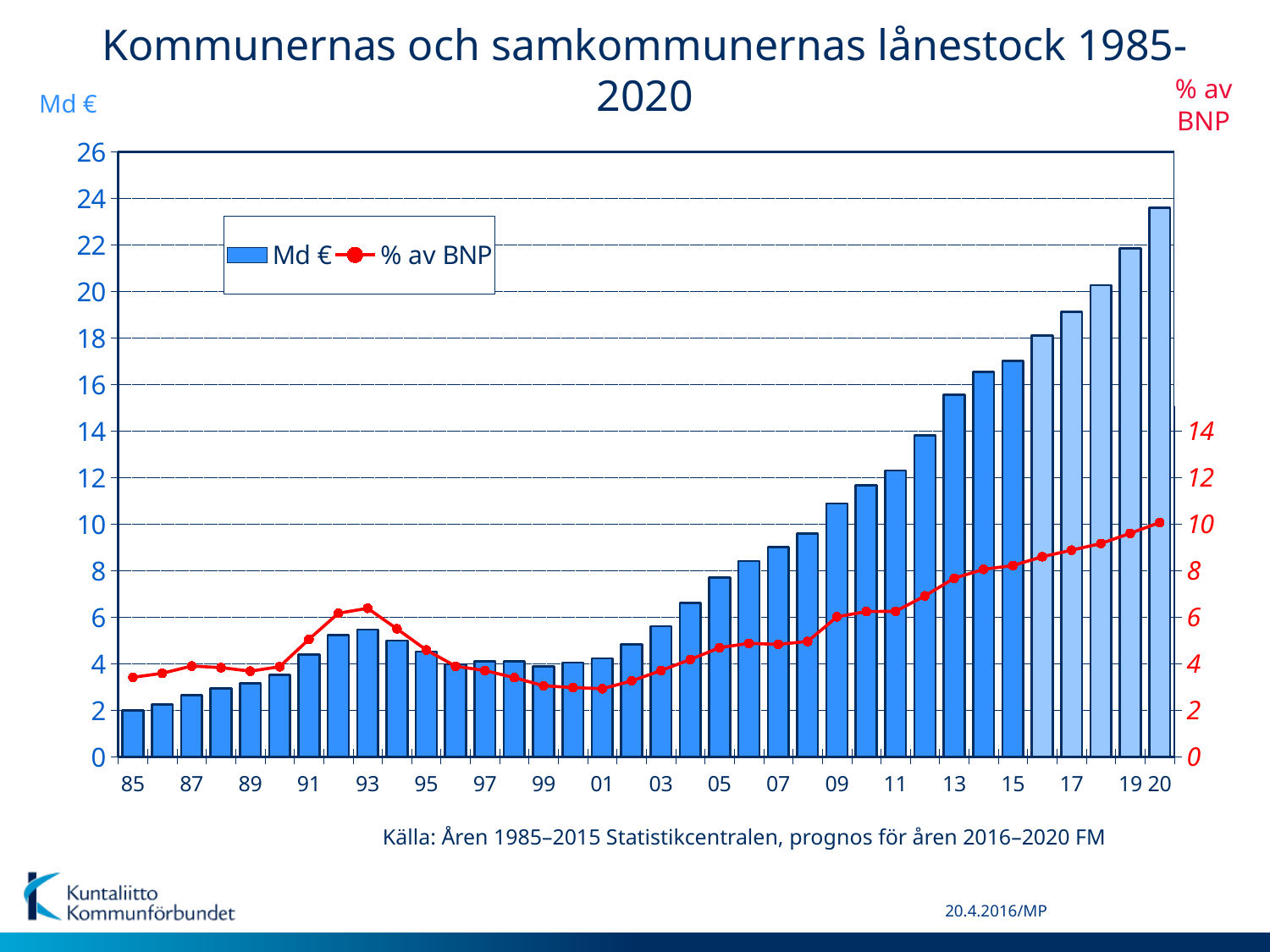
Is the Md € value for 2013 greater or less than 14? greater What kind of chart is shown on the slide? A combined bar and line chart Which year has a higher % av BNP value, 1993 or 2001? 1993 Is the Md € value for 2001 greater or less than 6? less Which year has the lowest Md € bar? 1985 Is the % av BNP value for 2001 greater or less than 4? less How many years (bars) are plotted in the chart? 36 Do the Md € bars rise or fall from 2001 to 2020? rise What are the two series named in the legend? Md € and % av BNP Which year has the highest Md € bar? 2020 How many series does the legend list? 2